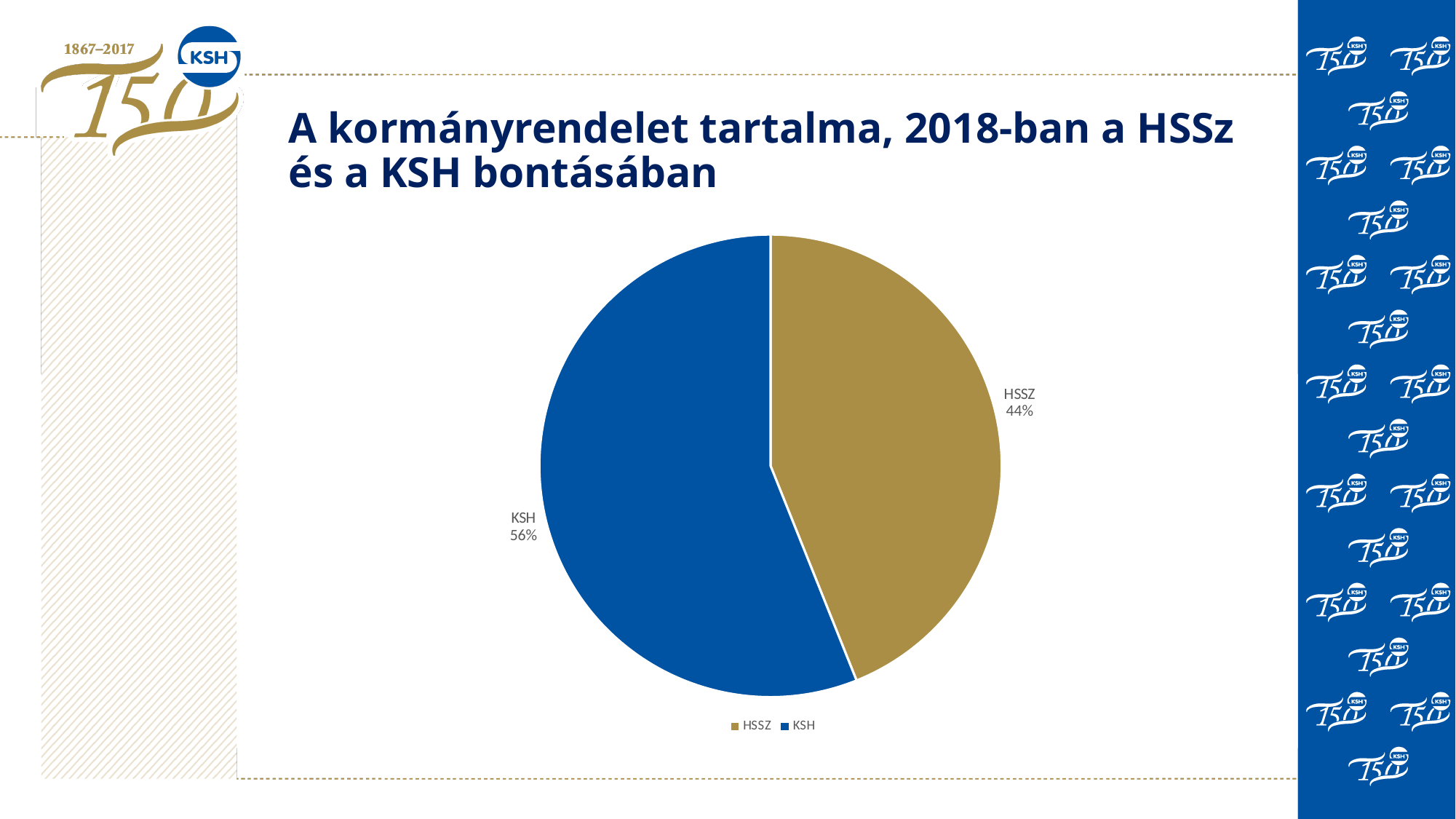
What share of the pie does HSSZ have? 44% How many slices does the pie chart have? 2 What share of the pie does KSH have? 56% What colour is the HSSZ slice? gold What colour is the KSH slice? blue What kind of chart is shown on the slide? pie chart Which slice is the smallest? HSSZ How many entries does the legend list? 2 Which slice is the largest? KSH What is the difference in percentage points between the KSH and HSSZ slices? 12 Which is larger, the HSSZ slice or the KSH slice? KSH